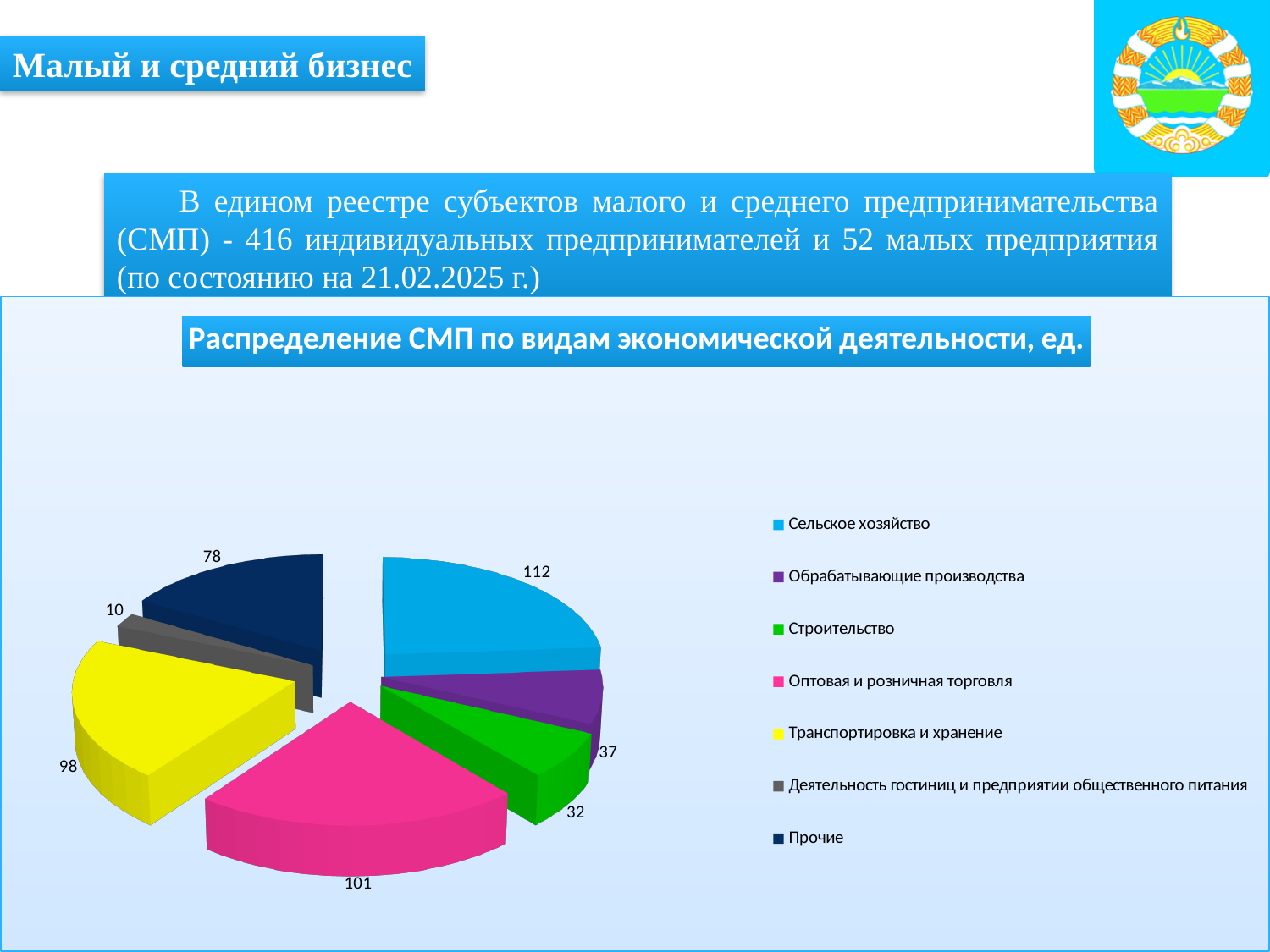
What is the value for Оптовая и розничная торговля in the pie chart? 101 What is the total of all values shown in the pie chart? 468 How many categories does the pie chart show? 7 What is the value for Деятельность гостиниц и предприятий общественного питания in the pie chart? 10 What is the title of the chart? Распределение СМП по видам экономической деятельности, ед. What type of chart is shown on the slide? Pie chart Which category has the smallest value in the pie chart? Деятельность гостиниц и предприятий общественного питания Which is larger: the value for Обрабатывающие производства or the value for Строительство? Обрабатывающие производства What is the value for Сельское хозяйство in the pie chart? 112 What is the difference between the values for Сельское хозяйство and Прочие? 34 Which category has the largest value in the pie chart? Сельское хозяйство What is the value for Транспортировка и хранение in the pie chart? 98